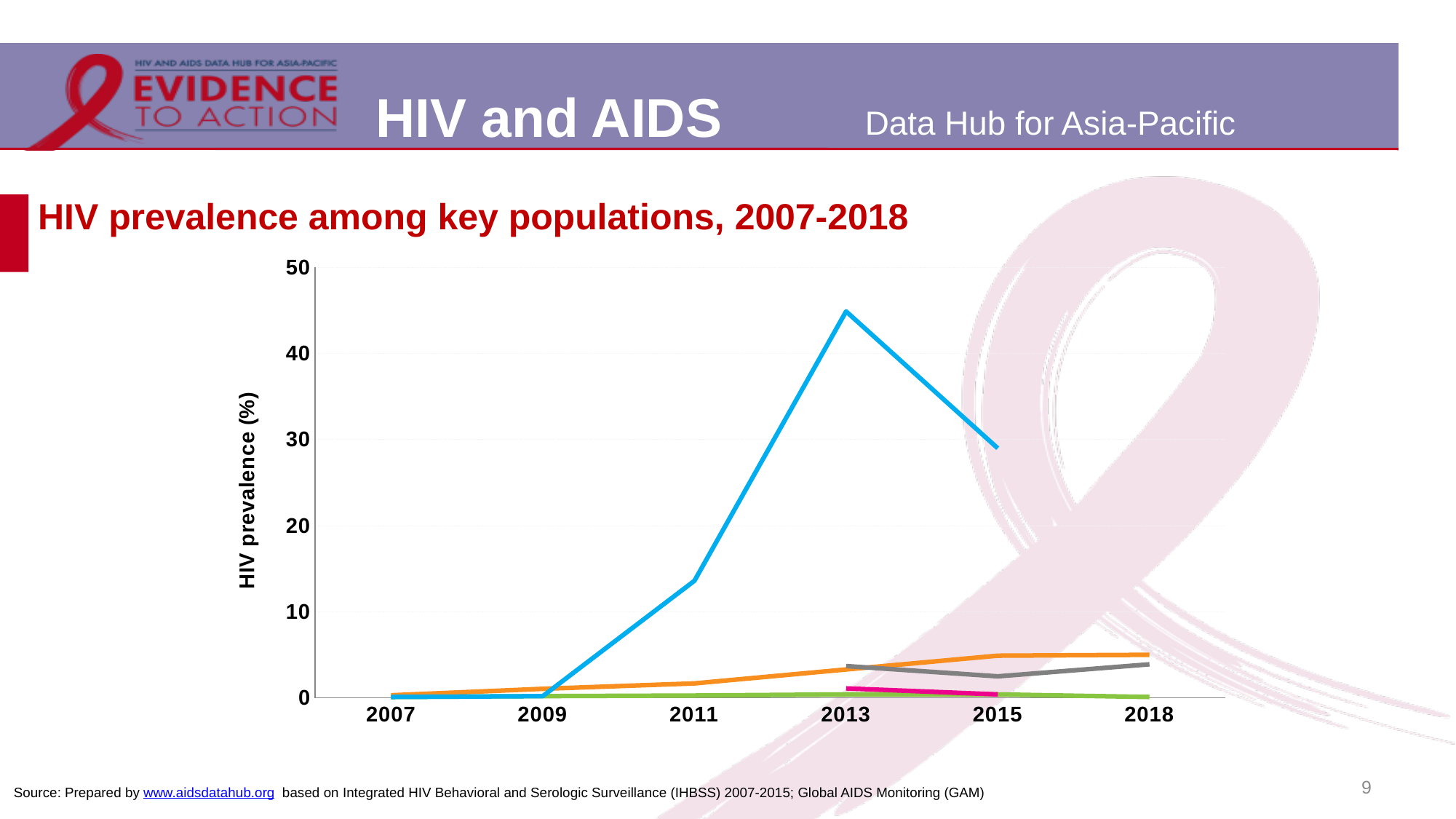
Is the value of the blue line in 2015 greater or less than 20? greater Does the blue line rise or fall between 2009 and 2013? Rises Which is larger in 2013, the value of the blue line or the value of the orange line? The blue line What kind of chart is shown on the slide? Line chart How many years are labelled on the x axis of the chart? 6 Is the value of the orange line in 2018 greater or less than 10? less Is the value of the blue line in 2011 greater or less than 10? greater Does the blue line rise or fall between 2013 and 2015? Falls In which year does the blue line reach its highest value? 2013 What is the title of the chart? HIV prevalence among key populations, 2007-2018 What is the label on the vertical axis of the chart? HIV prevalence (%)